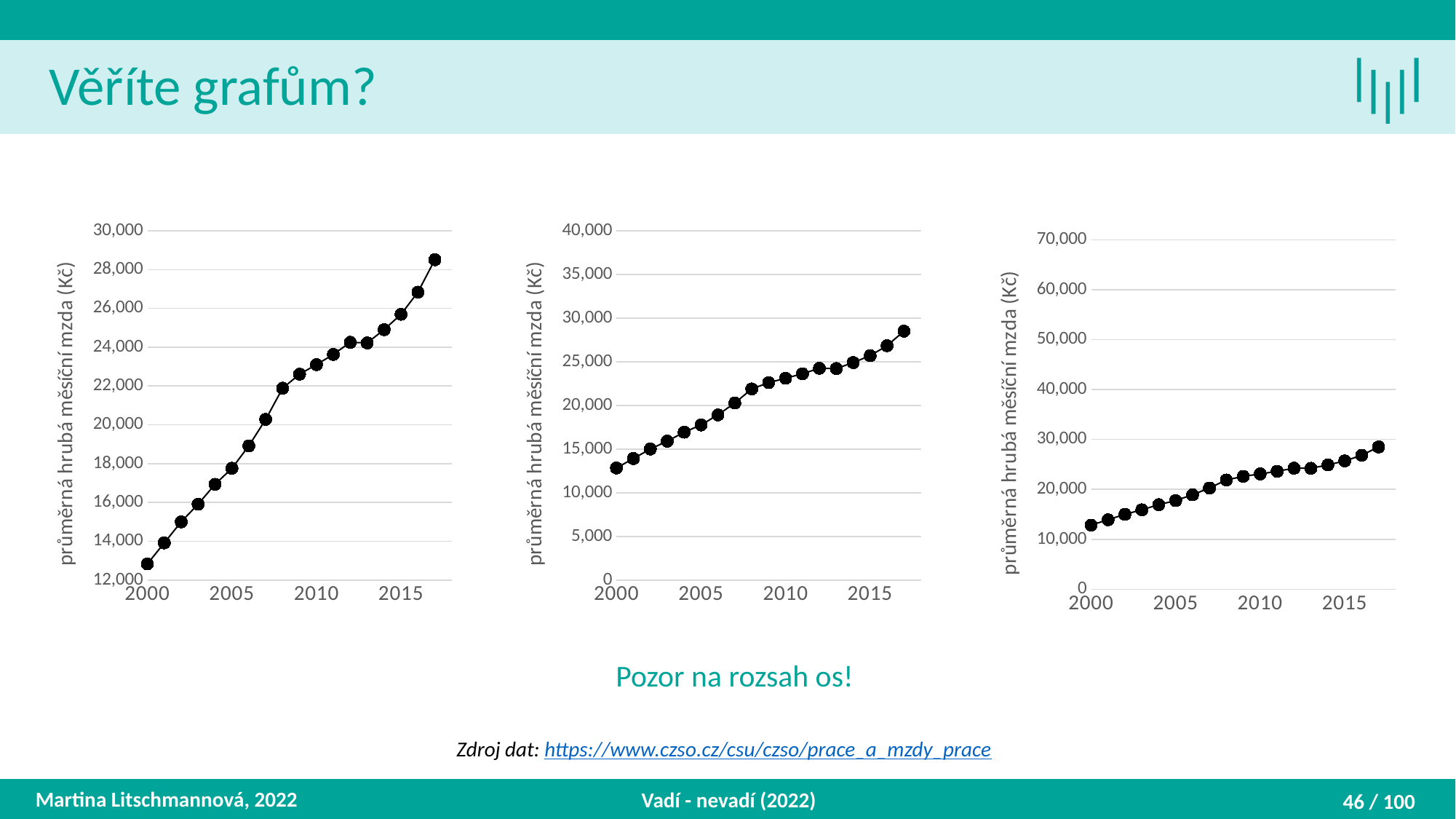
In the left chart, is the value for 2017 greater or less than 26,000? greater What is the highest tick value shown on the y axis of the right chart? 70,000 In the left chart, which year has the highest value? 2017 In the right chart, is the value for 2000 greater or less than 10,000? greater In the right chart, which year has the lowest value? 2000 In the left chart, do the values rise or fall from 2000 to 2017? rise What kind of chart is the left chart on the slide? line chart What is the lowest tick value shown on the y axis of the left chart? 12,000 In the middle chart, is the value for 2017 greater or less than 30,000? less In the middle chart, which is larger, the value for 2005 or the value for 2010? 2010 How many data points are plotted in the middle chart? 18